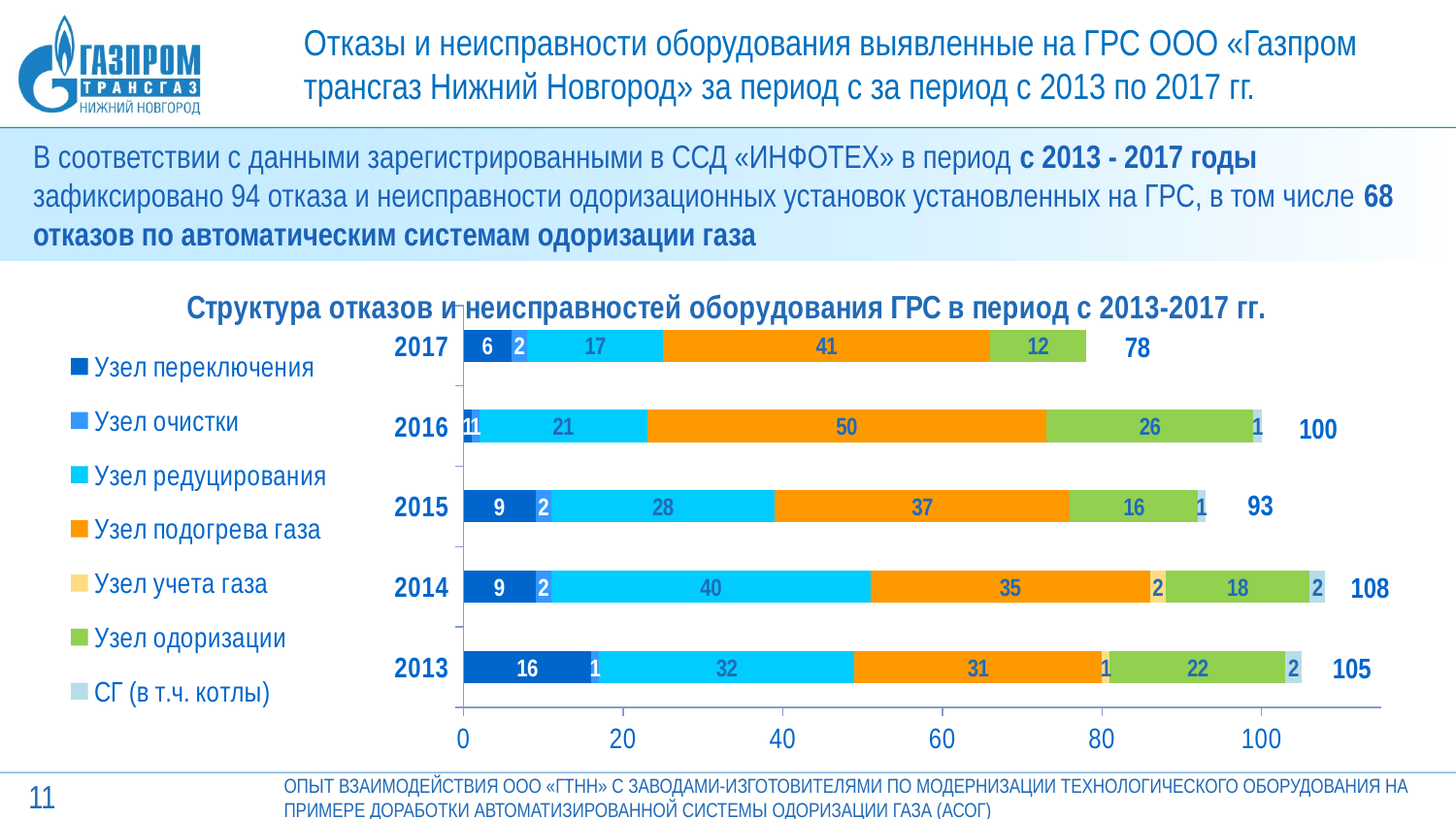
What is the value for Узел переключения in 2013? 16 What is the difference between the totals for 2016 and 2017? 22 How many years (categories) are plotted on the chart? 5 What is the value for Узел подогрева газа in 2016? 50 Which year has the lowest total of failures? 2017 What is the value for Узел редуцирования in 2014? 40 What kind of chart is shown on the slide? Stacked bar chart What is the value for Узел одоризации in 2017? 12 Which is larger: Узел подогрева газа in 2015 or Узел редуцирования in 2015? Узел подогрева газа What is the total of the stacked bar for 2015? 93 How many series does the legend list? 7 Which year has the highest total of failures? 2014